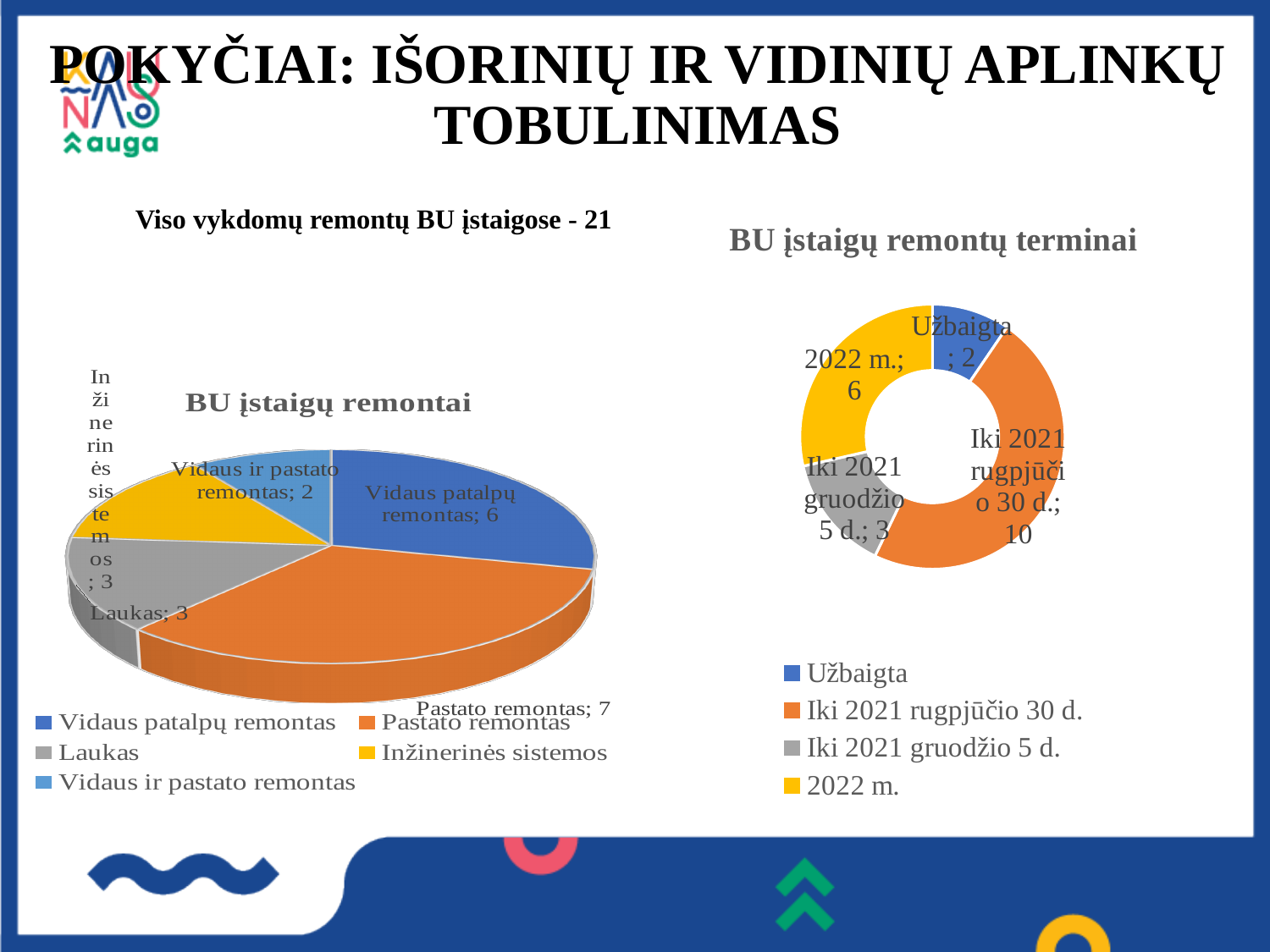
In the 'BU įstaigų remontai' chart, how many categories are shown? 5 In the 'BU įstaigų remontai' chart, what share of the total does Vidaus patalpų remontas represent? 6 of 21 In the 'BU įstaigų remontai' chart, which category has the lowest value? Vidaus ir pastato remontas In the 'BU įstaigų remontai' chart, what is the value for Vidaus ir pastato remontas? 2 In the 'BU įstaigų remontų terminai' chart, what is the value for Iki 2021 rugpjūčio 30 d.? 10 In the 'BU įstaigų remontų terminai' chart, what is the value for 2022 m.? 6 In the 'BU įstaigų remontai' chart, what is the difference between Pastato remontas and Laukas? 4 What type of chart is 'BU įstaigų remontų terminai'? Doughnut chart In the 'BU įstaigų remontai' chart, which category has the highest value? Pastato remontas In the 'BU įstaigų remontų terminai' chart, which is larger: Iki 2021 gruodžio 5 d. or 2022 m.? 2022 m. In the 'BU įstaigų remontai' chart, what is the value for Pastato remontas? 7 In the 'BU įstaigų remontų terminai' chart, which category has the lowest value? Užbaigta